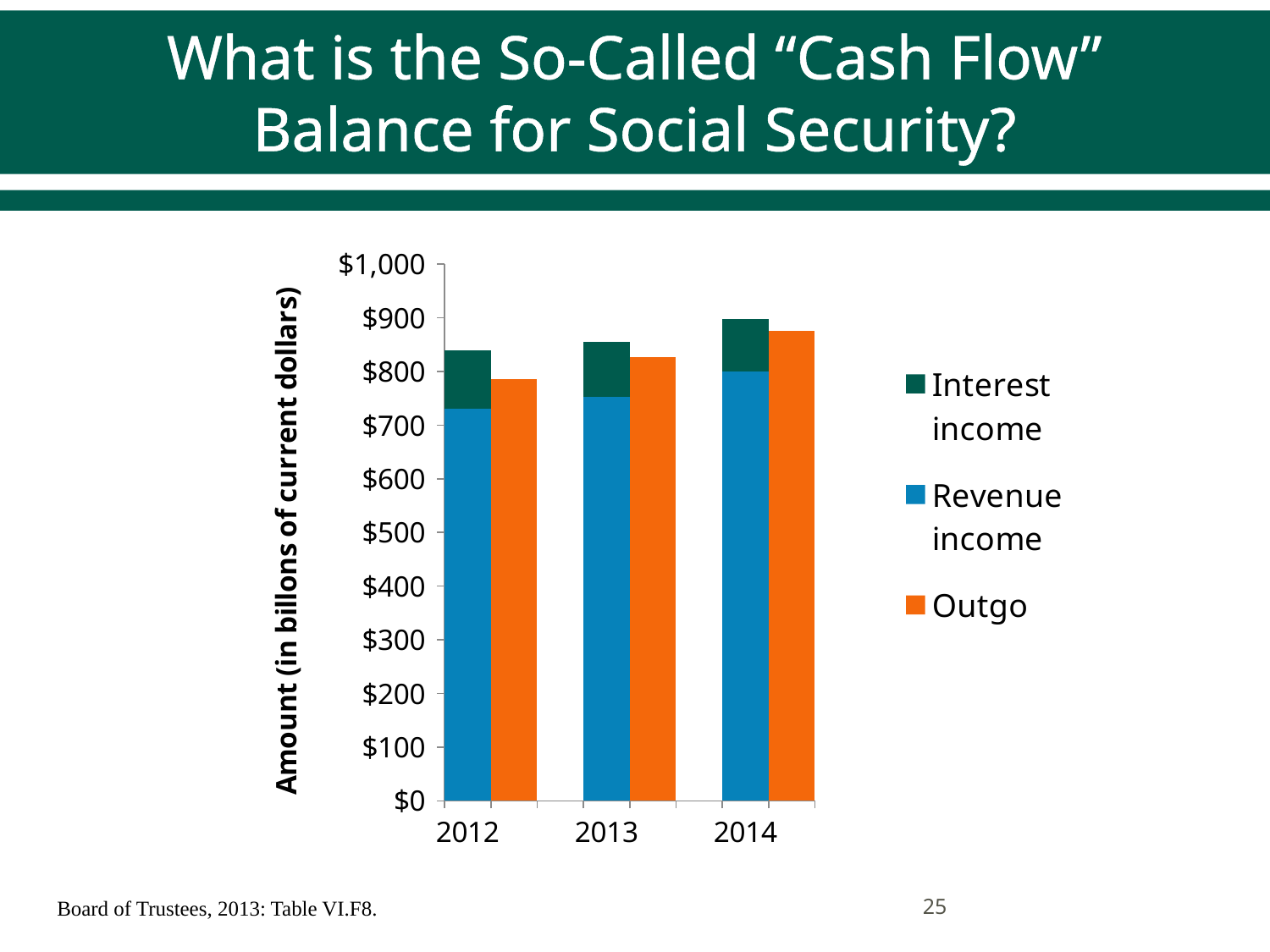
What kind of chart is shown on the slide? bar chart How many years are shown on the x axis of the chart? 3 Which is larger, the Revenue income for 2014 or the Revenue income for 2012? 2014 Is the Revenue income value for 2014 greater or less than $700? greater Is the Outgo value for 2012 greater or less than $700? greater Does Outgo rise or fall from 2012 to 2014? rise What is the title of the chart's vertical axis? Amount (in billons of current dollars) How many series does the chart's legend list? 3 Which year has the lowest Revenue income? 2012 Which year has the highest Outgo? 2014 Is the Revenue income value for 2012 greater or less than $800? less